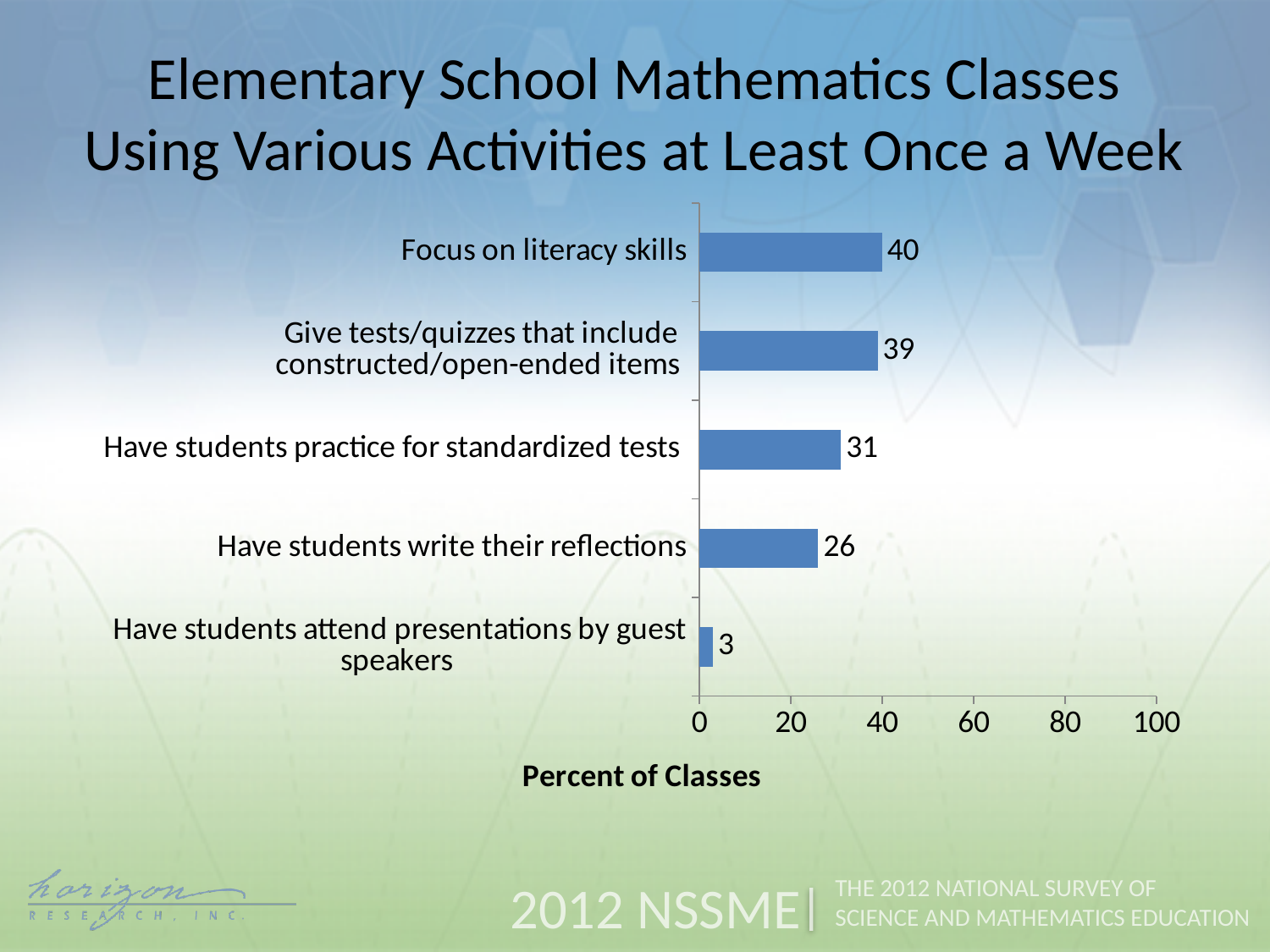
What percent of classes focus on literacy skills at least once a week? 40 What kind of chart is shown on the slide? Bar chart How many activities are shown in the chart? 5 What is the value for 'Have students practice for standardized tests'? 31 Is the value for 'Give tests/quizzes that include constructed/open-ended items' greater or less than 20? greater What is the difference between the values for 'Focus on literacy skills' and 'Have students write their reflections'? 14 Which is larger: the value for 'Have students practice for standardized tests' or 'Have students write their reflections'? Have students practice for standardized tests What is the difference between 'Have students practice for standardized tests' and 'Have students attend presentations by guest speakers'? 28 Which activity has the highest percent of classes? Focus on literacy skills What is the label of the horizontal axis? Percent of Classes Which activity has the lowest percent of classes? Have students attend presentations by guest speakers What percent of classes have students attend presentations by guest speakers at least once a week? 3